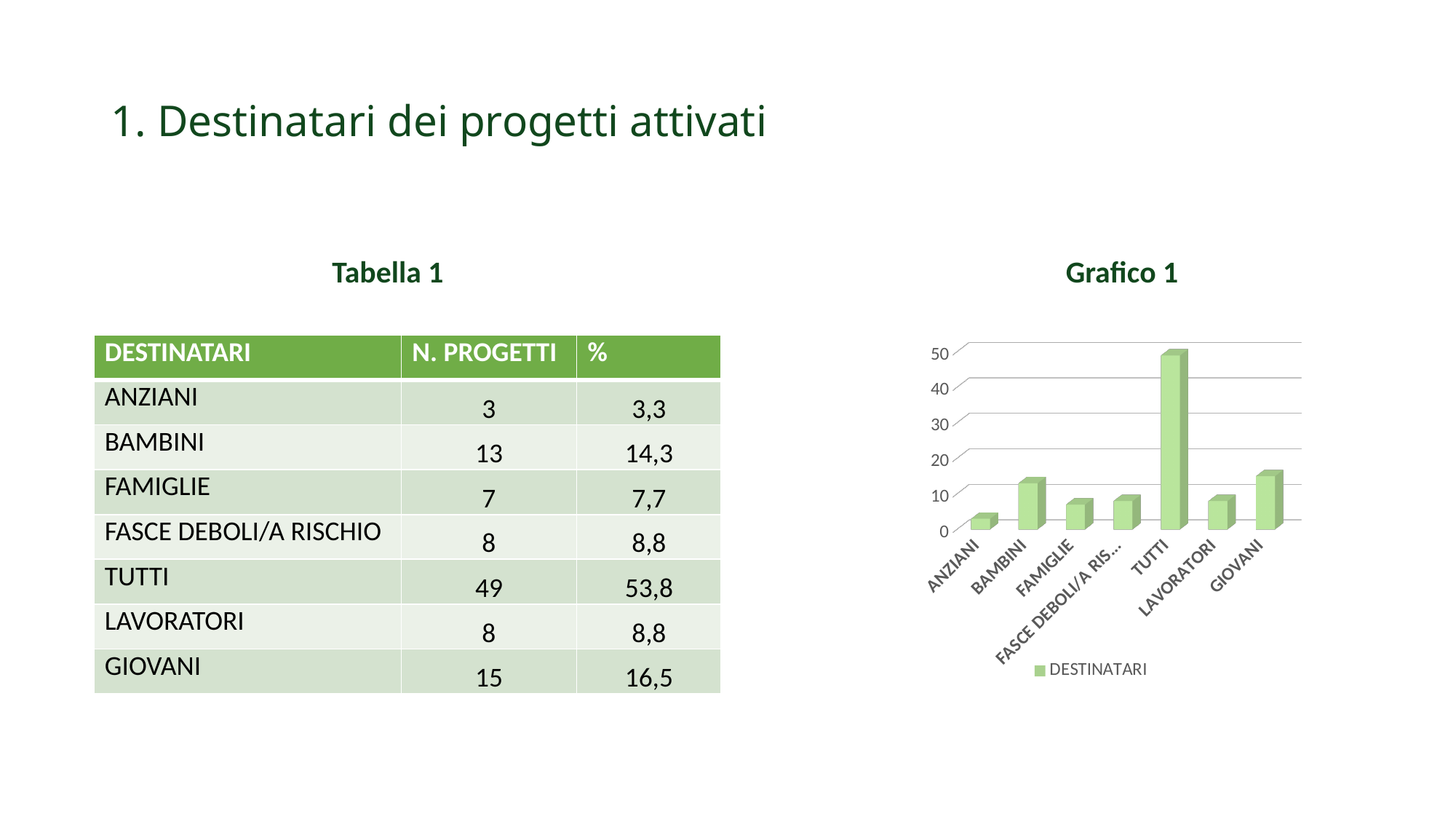
In Grafico 1, which category has the lowest bar? ANZIANI In Grafico 1, is the value for ANZIANI greater or less than 10? less According to Tabella 1, how many projects (N. PROGETTI) are there for TUTTI, the tallest bar in Grafico 1? 49 What kind of chart is Grafico 1? bar chart In Grafico 1, is the value for TUTTI greater or less than 40? greater What is the legend entry shown in Grafico 1? DESTINATARI In Grafico 1, which bar is taller, BAMBINI or FAMIGLIE? BAMBINI In Grafico 1, is the value for GIOVANI greater or less than 10? greater According to Tabella 1, what is the percentage (%) for GIOVANI? 16,5 How many series does the legend of Grafico 1 list? 1 In Grafico 1, which category has the highest bar? TUTTI How many categories are shown on the x axis of Grafico 1? 7